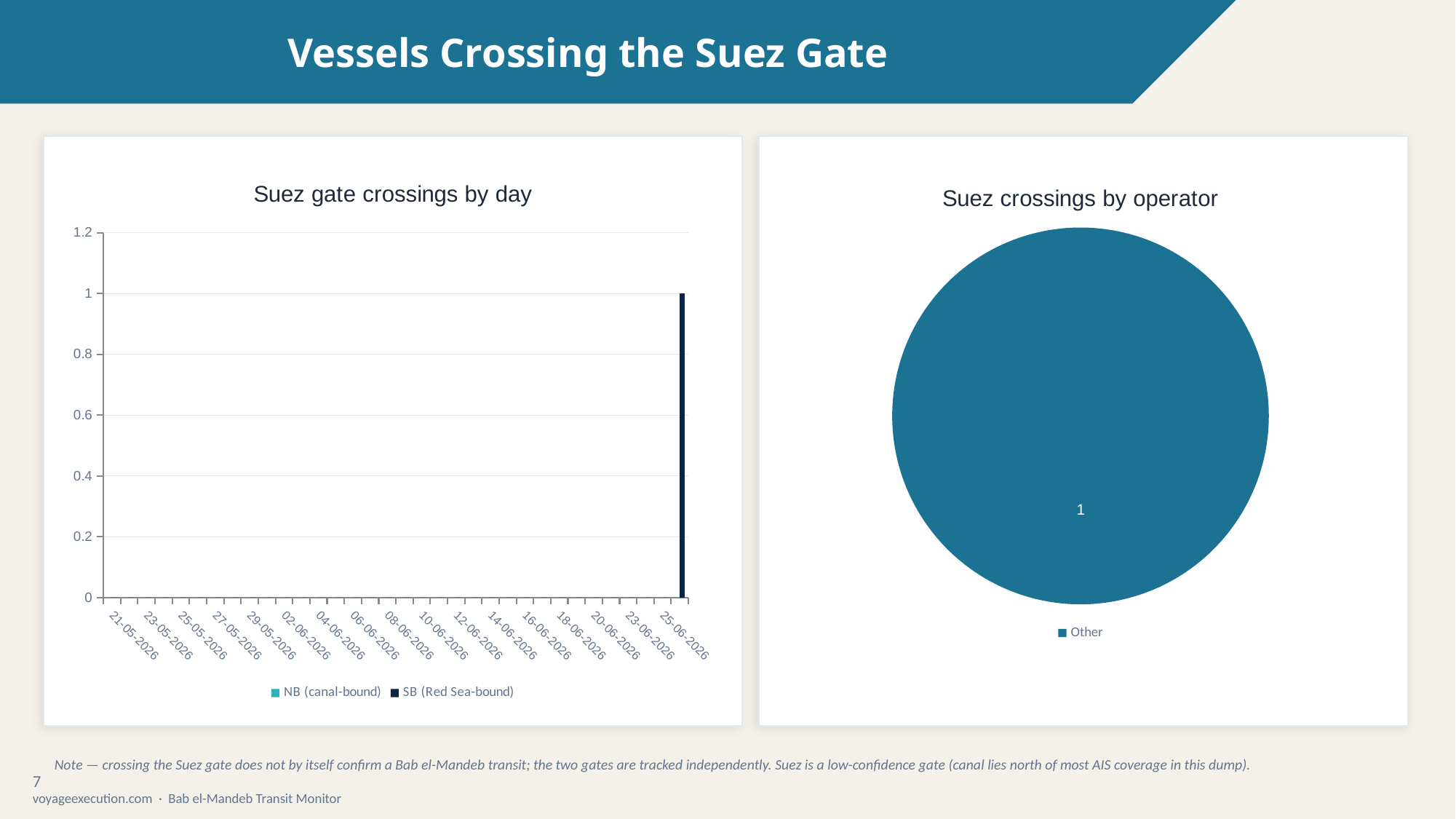
What kind of chart is "Suez crossings by operator"? pie chart In "Suez crossings by operator", how many slices does the pie have? 1 In "Suez gate crossings by day", how many series does the legend list? 2 In "Suez gate crossings by day", which series has the only visible bar? SB (Red Sea-bound) In "Suez gate crossings by day", what are the two series named in the legend? NB (canal-bound) and SB (Red Sea-bound) In "Suez crossings by operator", what share of the pie does the Other slice take? 100% In "Suez crossings by operator", what value is shown on the Other slice? 1 What kind of chart is "Suez gate crossings by day"? bar chart In "Suez crossings by operator", what is the only entry in the legend? Other